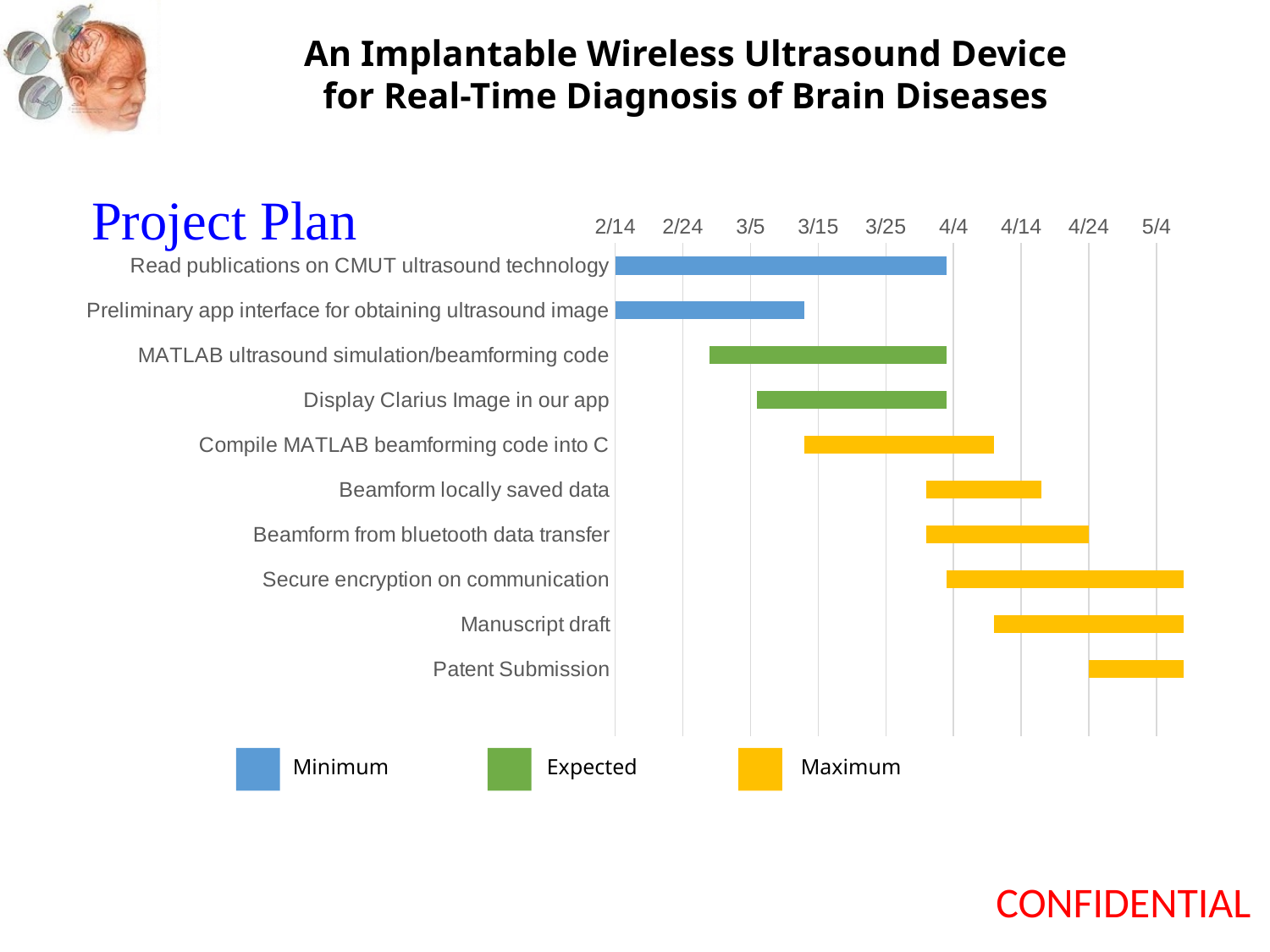
Does the bar for Preliminary app interface for obtaining ultrasound image end before or after 3/15? before How many tasks are listed on the Project Plan chart? 10 Does the bar for Read publications on CMUT ultrasound technology end before or after 3/25? after Which colour represents the Expected series in the Project Plan chart? Green Which task in the Project Plan chart has the longest bar? Read publications on CMUT ultrasound technology Does the bar for Patent Submission start before or after 4/14? after Which series in the Project Plan chart is shown in yellow? Maximum Which task ends later in the Project Plan chart: Beamform locally saved data or Beamform from bluetooth data transfer? Beamform from bluetooth data transfer Which task in the Project Plan chart has the shortest bar? Patent Submission How many series does the legend of the Project Plan chart list? 3 What kind of chart is shown on the Project Plan slide? Bar chart (Gantt chart) Which task in the Project Plan chart starts last? Patent Submission